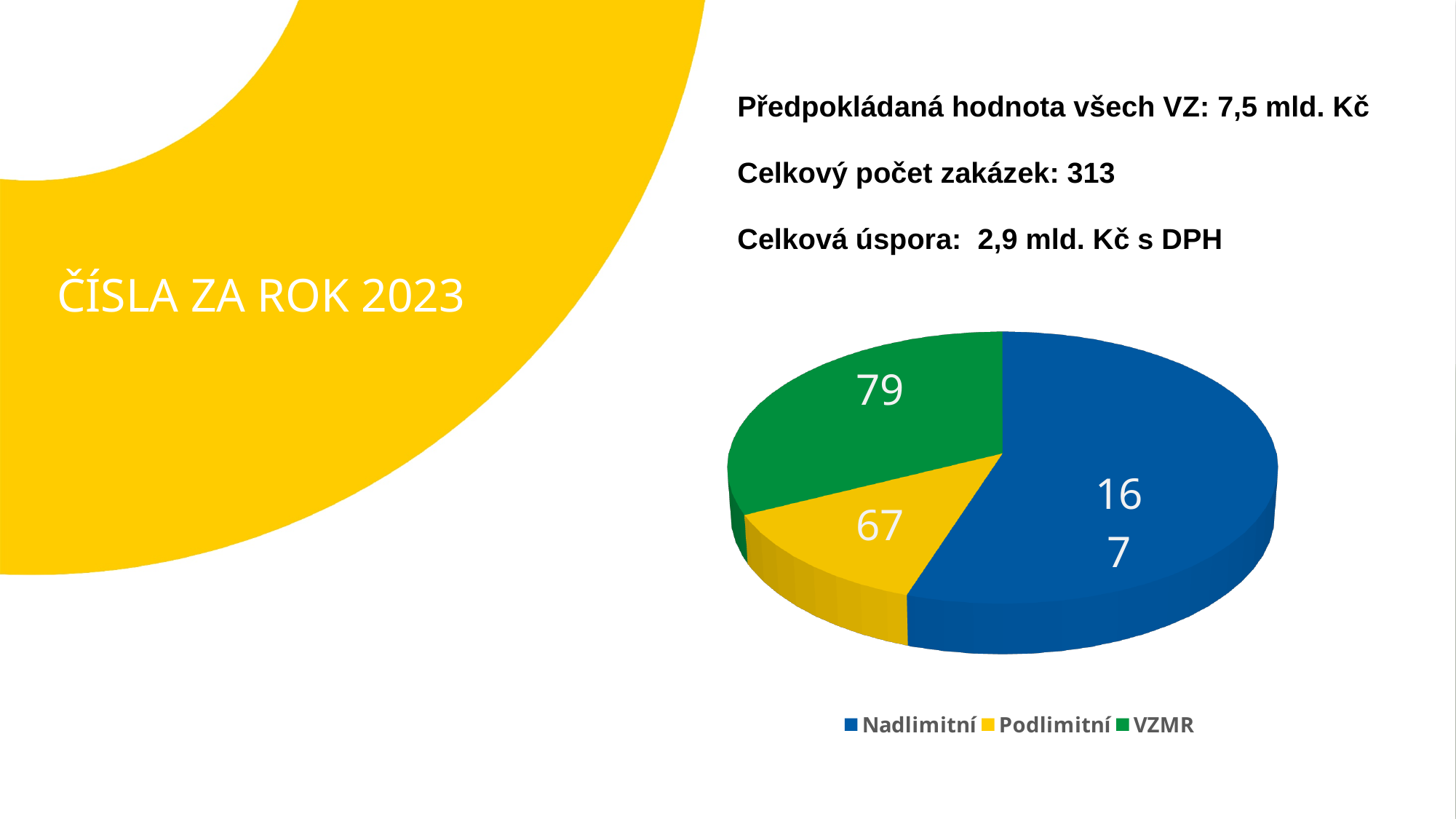
Which is larger, the value for VZMR or the value for Podlimitní? VZMR What is the difference between the values for Nadlimitní and VZMR? 88 Which category has the largest slice in the pie chart? Nadlimitní What is the value for VZMR in the pie chart? 79 Which colour represents VZMR in the pie chart? green Which category has the smallest slice in the pie chart? Podlimitní How many slices does the pie chart have? 3 What is the difference between the values for VZMR and Podlimitní? 12 What is the value for Podlimitní in the pie chart? 67 What is the value for Nadlimitní in the pie chart? 167 What kind of chart is shown on the slide? pie chart What is the total of all slices in the pie chart? 313